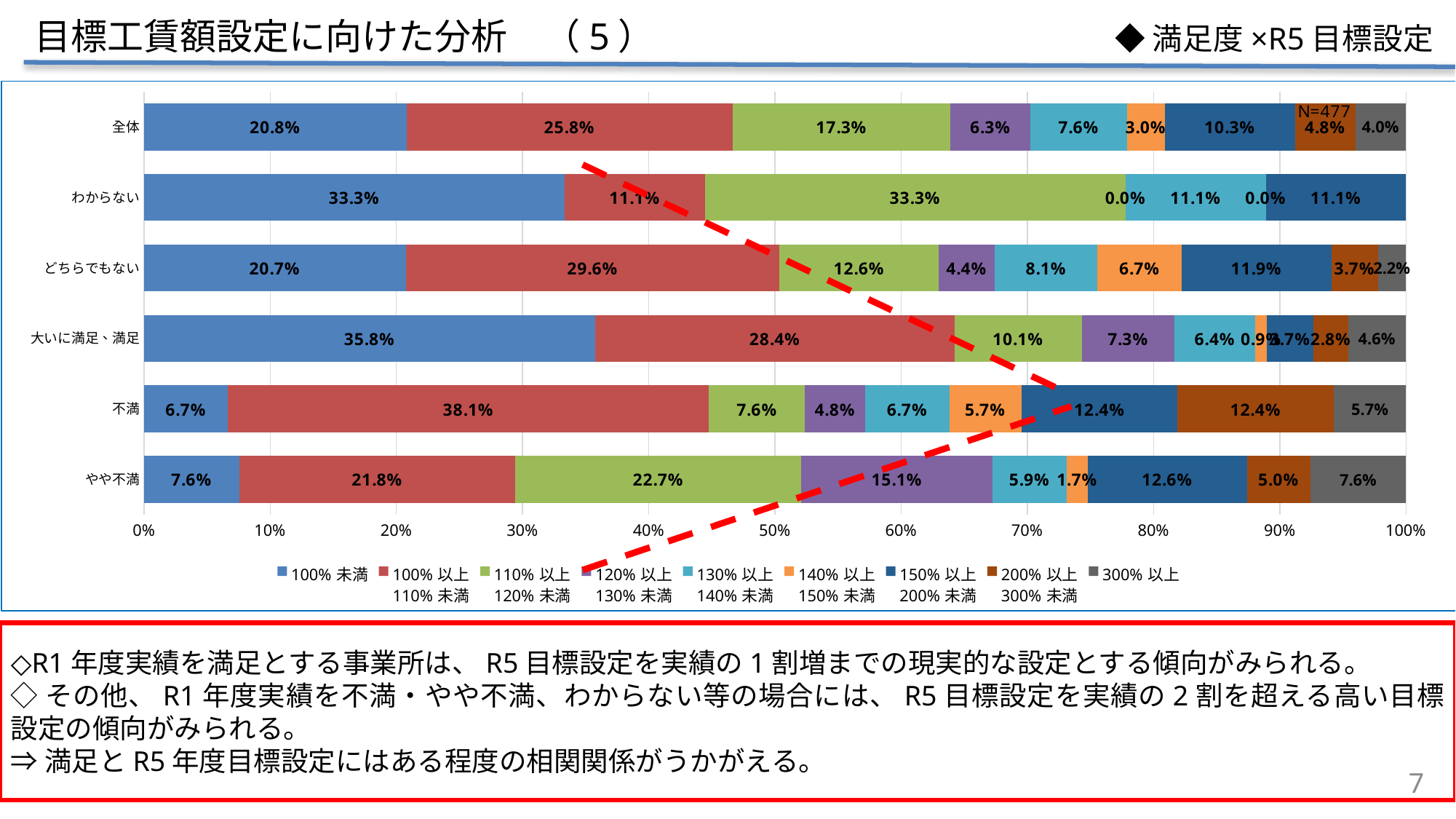
What is the value of the 100% 未満 segment for 全体? 20.8% What is the sample size (N) shown on the chart? N=477 What is the value of the 110% 以上 120% 未満 segment for やや不満? 22.7% What kind of chart is shown on the slide? Stacked bar chart Which category has the largest 100% 未満 segment? 大いに満足、満足 What is the value of the 200% 以上 300% 未満 segment for どちらでもない? 3.7% What is the difference between the 100% 未満 values for 大いに満足、満足 and 全体? 15.0% Which is larger: the 150% 以上 200% 未満 segment for 不満 or for 全体? 不満 How many categories are shown on the vertical axis? 6 What is the value of the 100% 以上 110% 未満 segment for 不満? 38.1% How many series does the legend list? 9 Which category has the smallest 100% 未満 segment? 不満